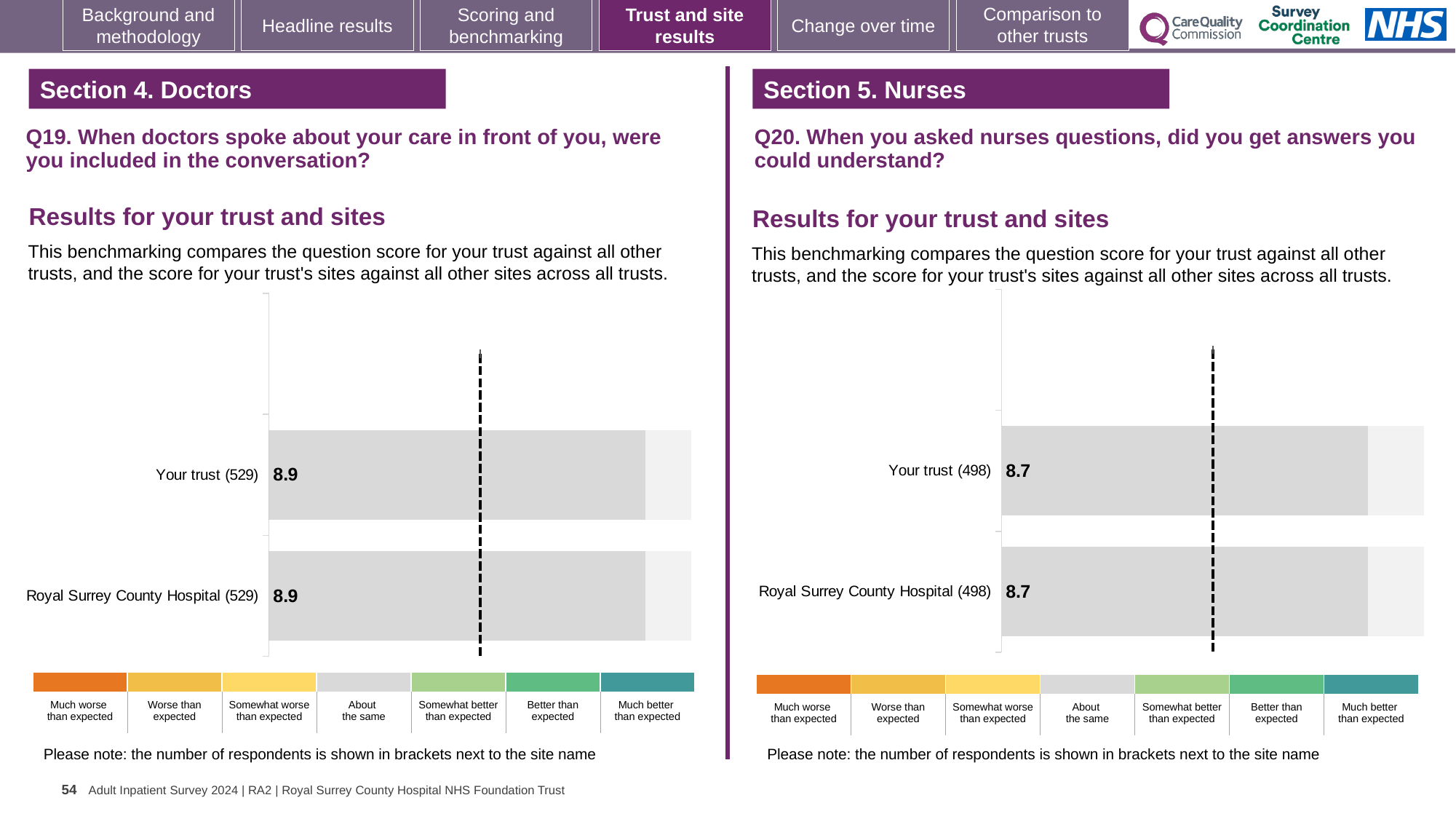
On the Q19 chart (left), how many respondents are shown in brackets next to Your trust? 529 On the Q20 chart (right), how many respondents are shown in brackets next to Royal Surrey County Hospital? 498 What kind of chart is the Q19 chart (left)? Bar chart On the Q20 chart (right), what is the score for Your trust? 8.7 On the Q19 chart (left), what is the difference between the score for Your trust and the score for Royal Surrey County Hospital? 0 On the Q19 chart (left), what is the score for Royal Surrey County Hospital? 8.9 On the Q20 chart (right), what is the difference between the score for Your trust and the score for Royal Surrey County Hospital? 0 On the Q20 chart (right), what is the score for Royal Surrey County Hospital? 8.7 How many bars are plotted on the Q20 chart (right)? 2 How many bars are plotted on the Q19 chart (left)? 2 Is the score for Your trust on the Q20 chart (right) higher or lower than the score for Your trust on the Q19 chart (left)? Lower On the Q19 chart (left), what is the score for Your trust? 8.9